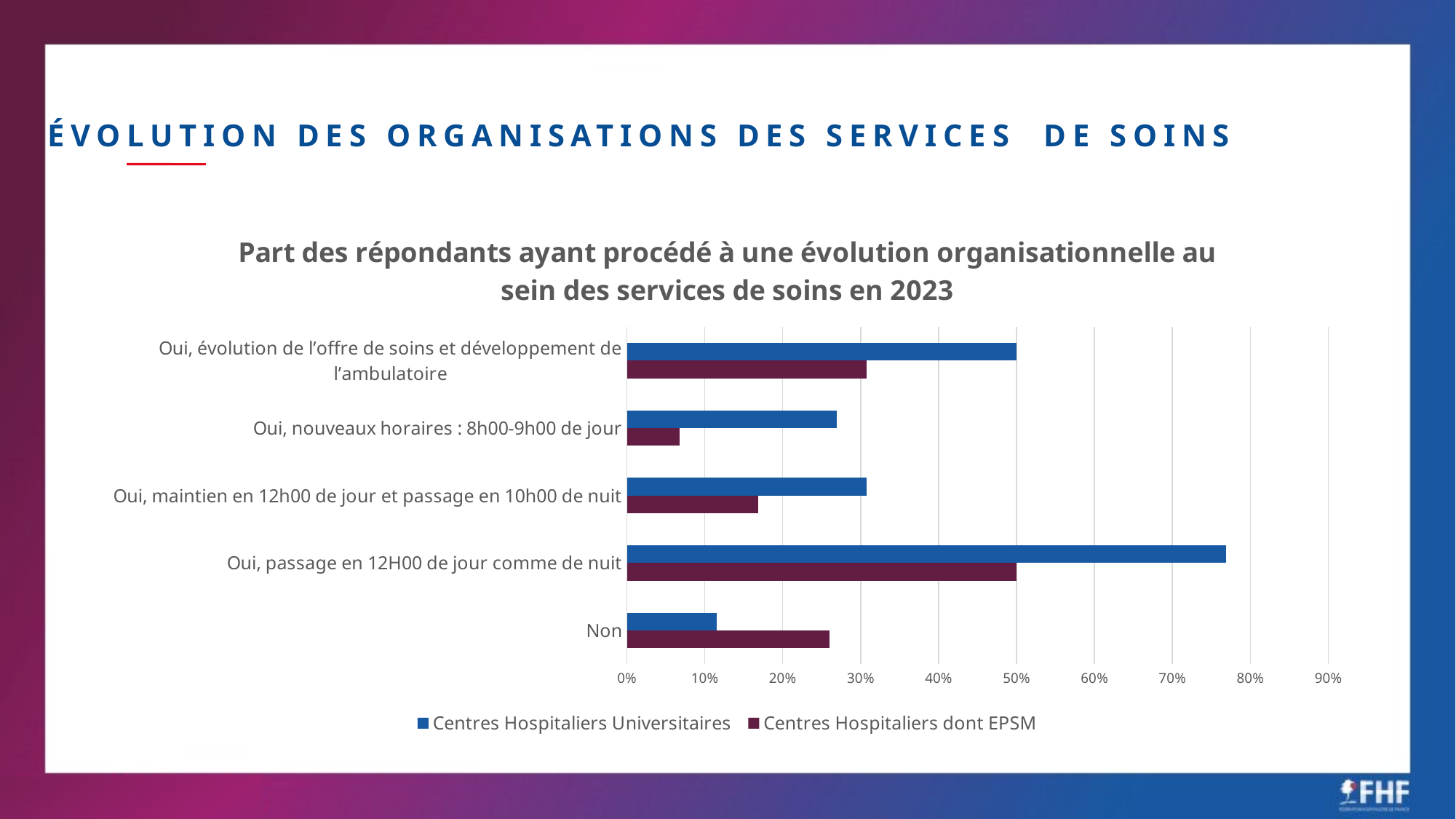
For the 'Non' category, which series has the larger value? Centres Hospitaliers dont EPSM For the Centres Hospitaliers Universitaires series, which category has the highest value? Oui, passage en 12H00 de jour comme de nuit For 'Oui, évolution de l'offre de soins et développement de l'ambulatoire', which series has the larger value? Centres Hospitaliers Universitaires What kind of chart is shown on the slide? Bar chart For the Centres Hospitaliers dont EPSM series, which category has the highest value? Oui, passage en 12H00 de jour comme de nuit How many series does the legend list? 2 Is the Centres Hospitaliers dont EPSM value for 'Oui, nouveaux horaires : 8h00-9h00 de jour' greater or less than 10%? less For the Centres Hospitaliers Universitaires series, which category has the lowest value? Non How many response categories are plotted on the chart? 5 Is the Centres Hospitaliers Universitaires value for 'Oui, passage en 12H00 de jour comme de nuit' greater or less than 70%? greater What colour represents the Centres Hospitaliers Universitaires series? Blue For the Centres Hospitaliers dont EPSM series, which category has the lowest value? Oui, nouveaux horaires : 8h00-9h00 de jour